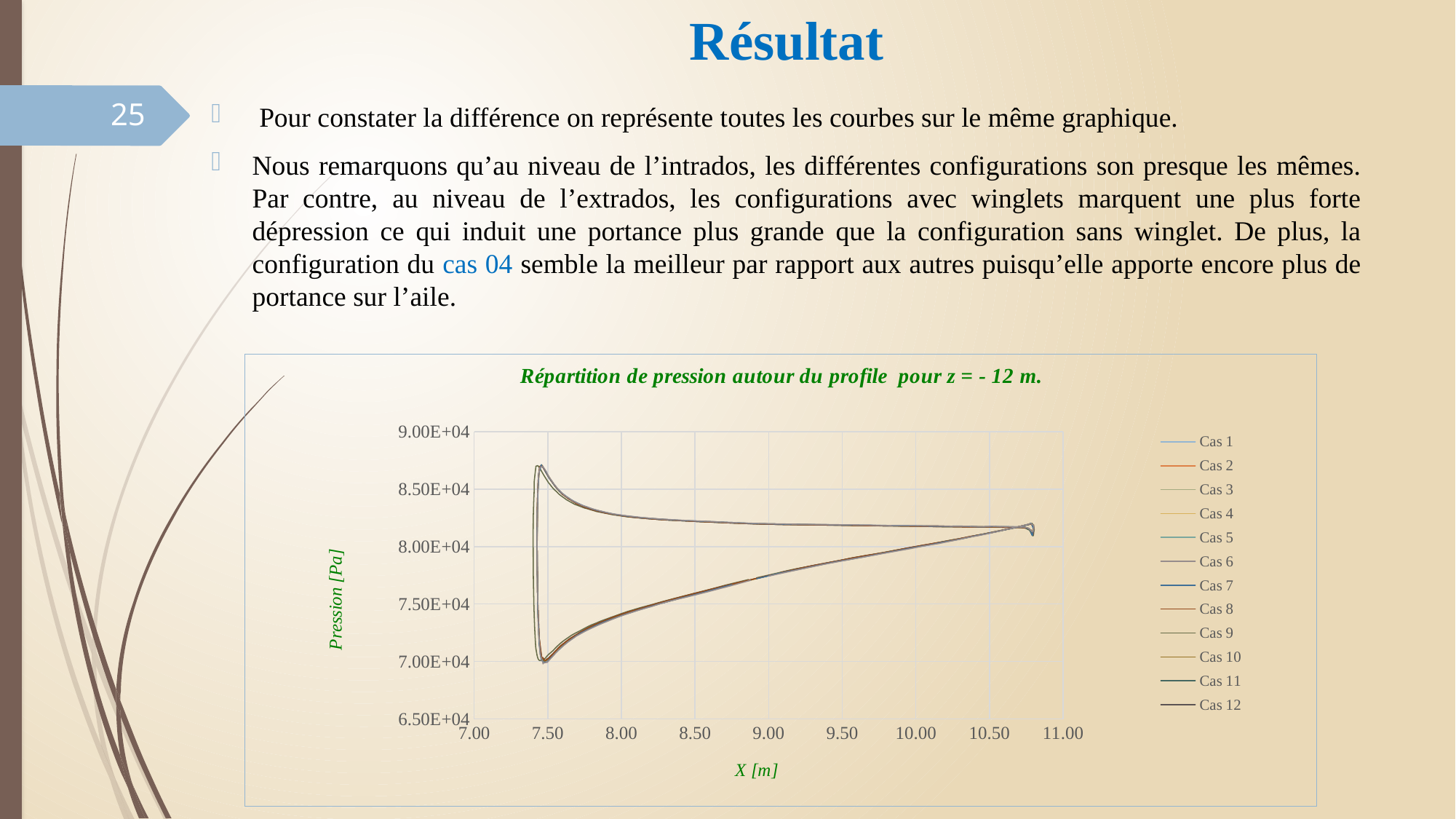
Is the lowest pressure value plotted on the chart greater or less than 7.50E+04? less On the upper curve of the chart, is the pressure at X = 9.00 greater or less than 8.50E+04? less Along the lower curve, does the pressure rise or fall as X increases from 7.50 to 10.50? rise What is the label of the vertical axis of the chart? Pression [Pa] What is the title of the chart? Répartition de pression autour du profile pour z = - 12 m. On the lower curve of the chart, is the pressure at X = 9.00 greater or less than 7.50E+04? greater What kind of chart is shown on the slide? Line chart Along the upper curve, does the pressure rise or fall as X increases from 7.50 to 10.50? fall What is the name of the last series listed in the chart legend? Cas 12 How many series does the legend of the chart list? 12